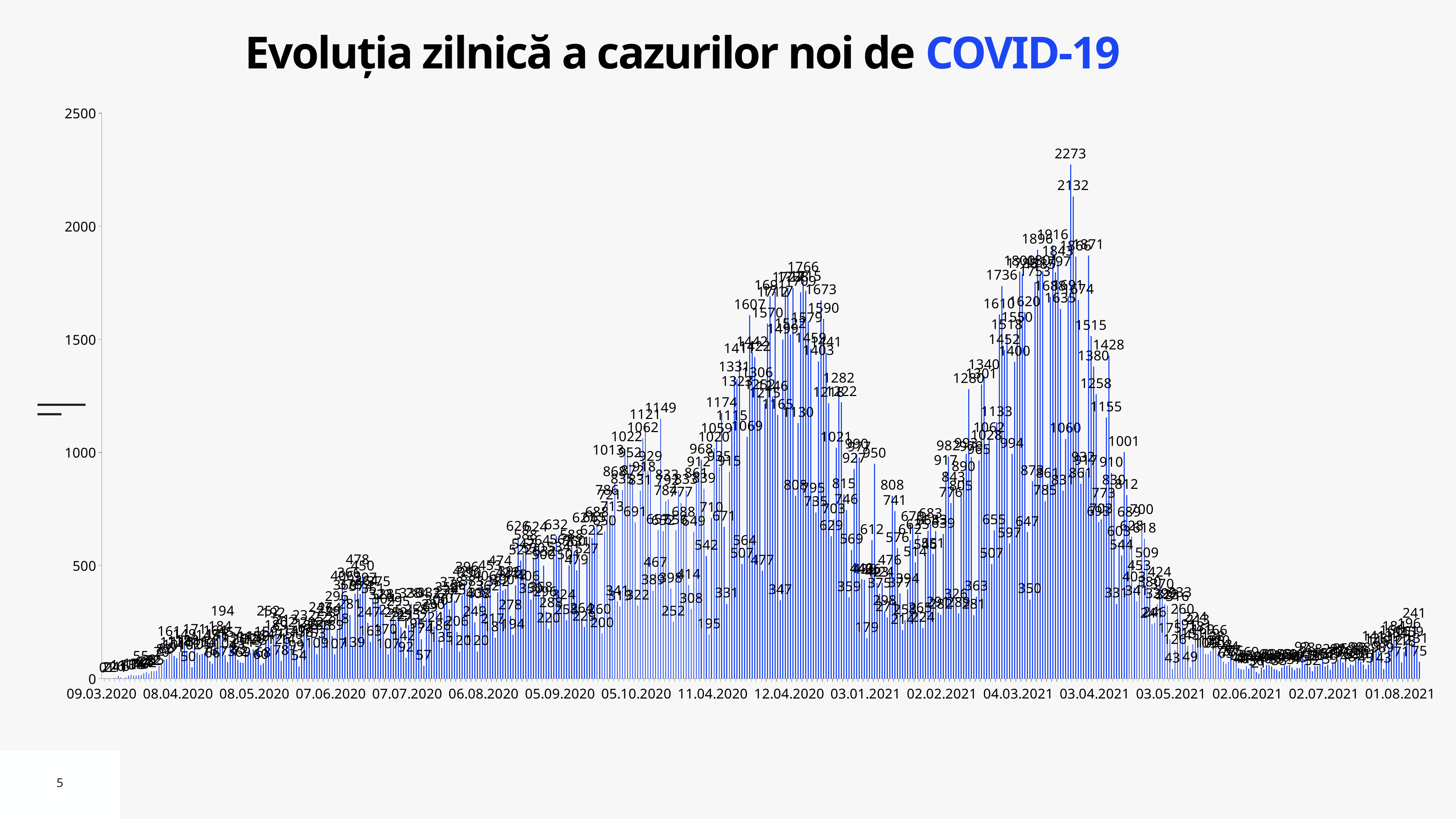
What is the highest value labelled in the wave around the 12.04.2020 axis label? 1766 Is the highest bar in the first wave (around 07.06.2020, labelled 478) greater or less than 500? less Do the values rise or fall between the 03.04.2021 peak and 02.06.2021? fall Which peak is larger: the one near 03.04.2021 or the one near 12.04.2020? the one near 03.04.2021 What is the title of the chart? Evoluția zilnică a cazurilor noi de COVID-19 What is the difference between the two highest labelled values, 2273 and 2132? 141 What is the first date label on the horizontal axis? 09.03.2020 Is the highest bar on the chart greater or less than 2000? greater What is the second-highest daily value labelled on the chart, next to the 2273 peak? 2132 What is the maximum value shown on the vertical axis? 2500 What is the highest daily value labelled on the chart? 2273 What kind of chart is shown on the slide? bar chart